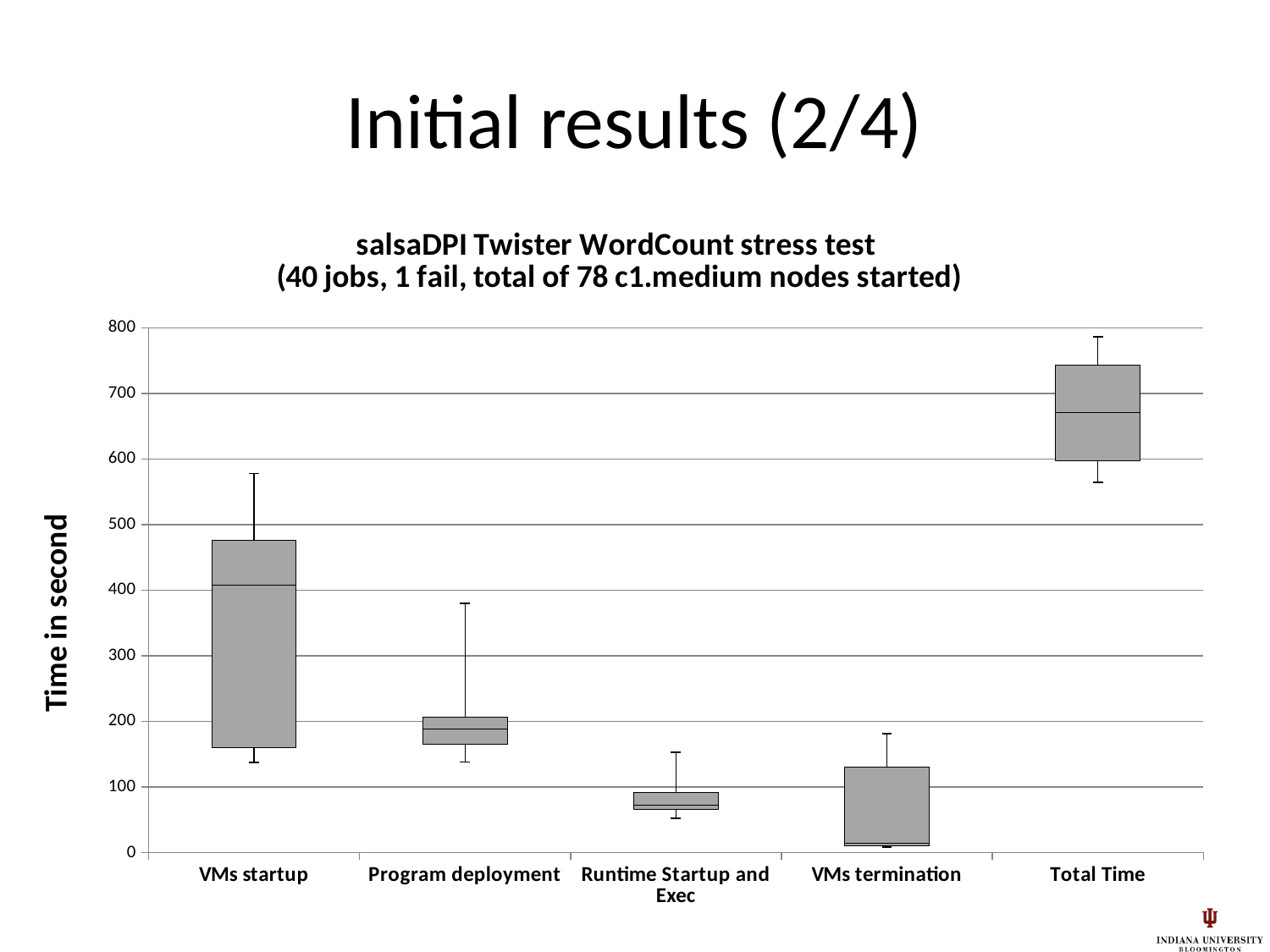
What is the label of the y axis of the chart? Time in second Which has a larger median time, VMs startup or Program deployment? VMs startup Which category has the lowest median time in the chart? VMs termination What is the maximum value shown on the y axis of the chart? 800 Which category has the highest median time in the chart? Total Time Is the top whisker for VMs startup greater or less than 600? less Is the median value for Runtime Startup and Exec greater or less than 100? less How many categories are shown along the x axis of the chart? 5 Is the median value for Program deployment greater or less than 300? less Which has a larger median time, Runtime Startup and Exec or VMs termination? Runtime Startup and Exec What kind of chart is shown on the slide? Box plot